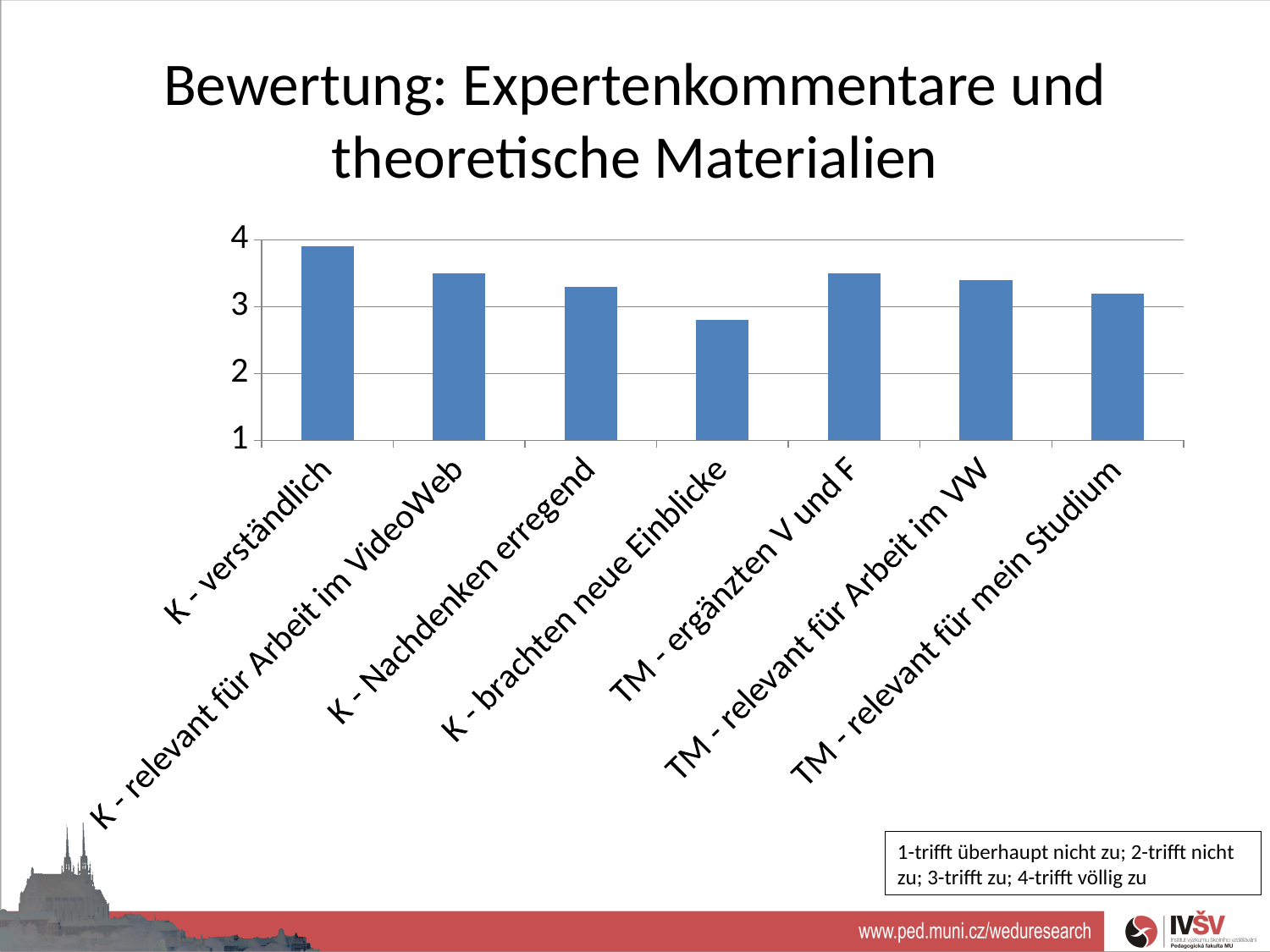
Is the value for K - brachten neue Einblicke greater or less than 3? less Which is larger: the value for K - Nachdenken erregend or the value for K - brachten neue Einblicke? K - Nachdenken erregend Is the value for K - verständlich greater or less than 3? greater Is the value for TM - relevant für mein Studium greater or less than 3? greater What is the highest value shown on the vertical axis of the chart? 4 What is the title of the slide containing the chart? Bewertung: Expertenkommentare und theoretische Materialien Which category has the highest value in the chart? K - verständlich Which is larger: the value for K - verständlich or the value for TM - relevant für mein Studium? K - verständlich Which category has the lowest value in the chart? K - brachten neue Einblicke How many categories are plotted in the chart? 7 What kind of chart is shown on the slide? bar chart